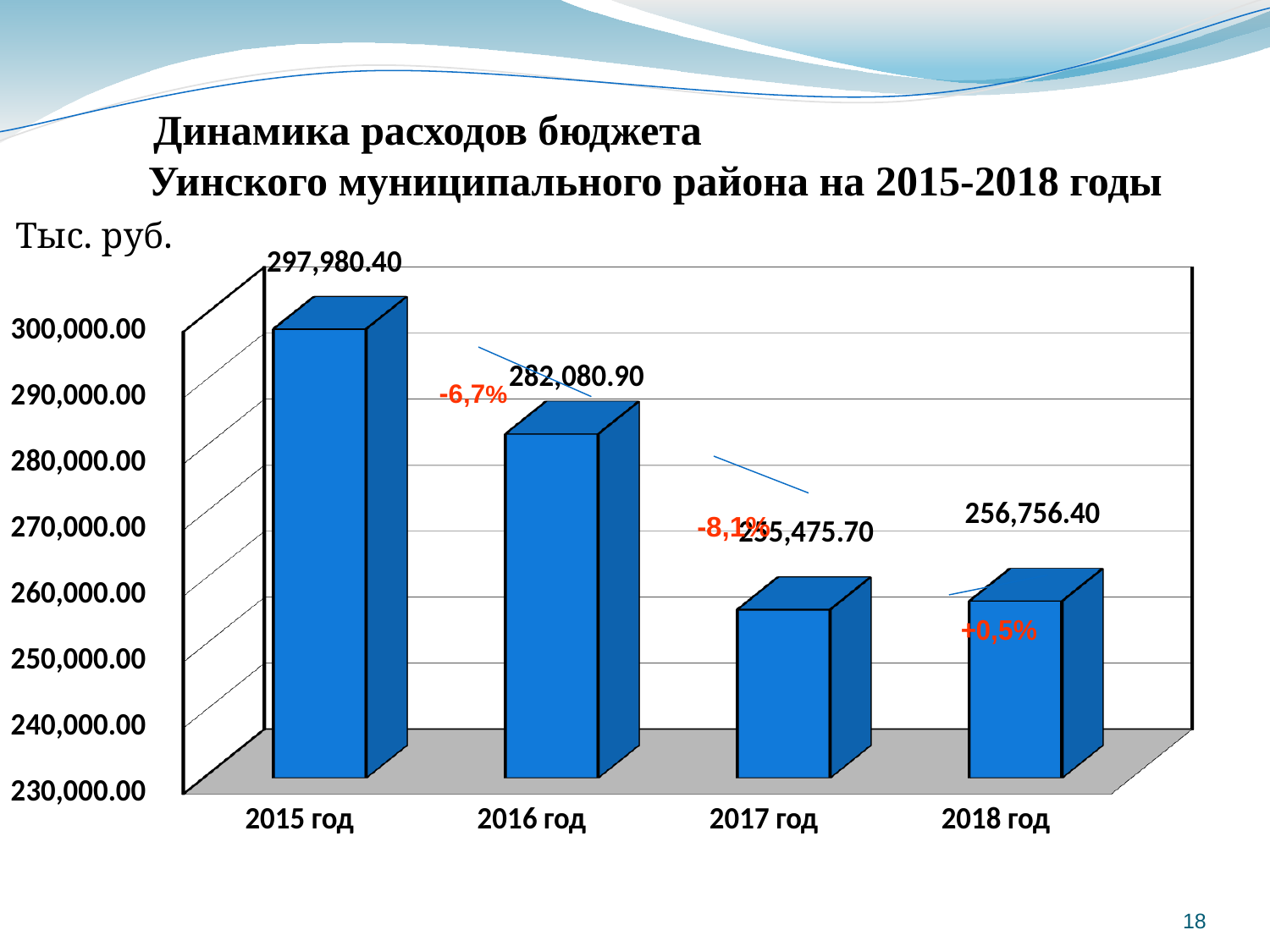
What is the budget expenditure value shown for 2018 год? 256,756.40 Which is larger, the value for 2015 год or the value for 2018 год? 2015 год What is the difference between the 2015 год and 2016 год values? 15,899.50 What is the budget expenditure value shown for 2015 год? 297,980.40 What percentage change is annotated next to the 2016 год bar? -6,7% What is the difference between the 2015 год and 2018 год values? 41,224.00 What is the budget expenditure value shown for 2016 год? 282,080.90 What kind of chart is shown on the slide? bar chart Is the value for 2017 год greater or less than 260,000.00? less Which year has the highest budget expenditure? 2015 год Do the values rise or fall from 2015 год to 2017 год? fall How many years (categories) are shown on the chart? 4